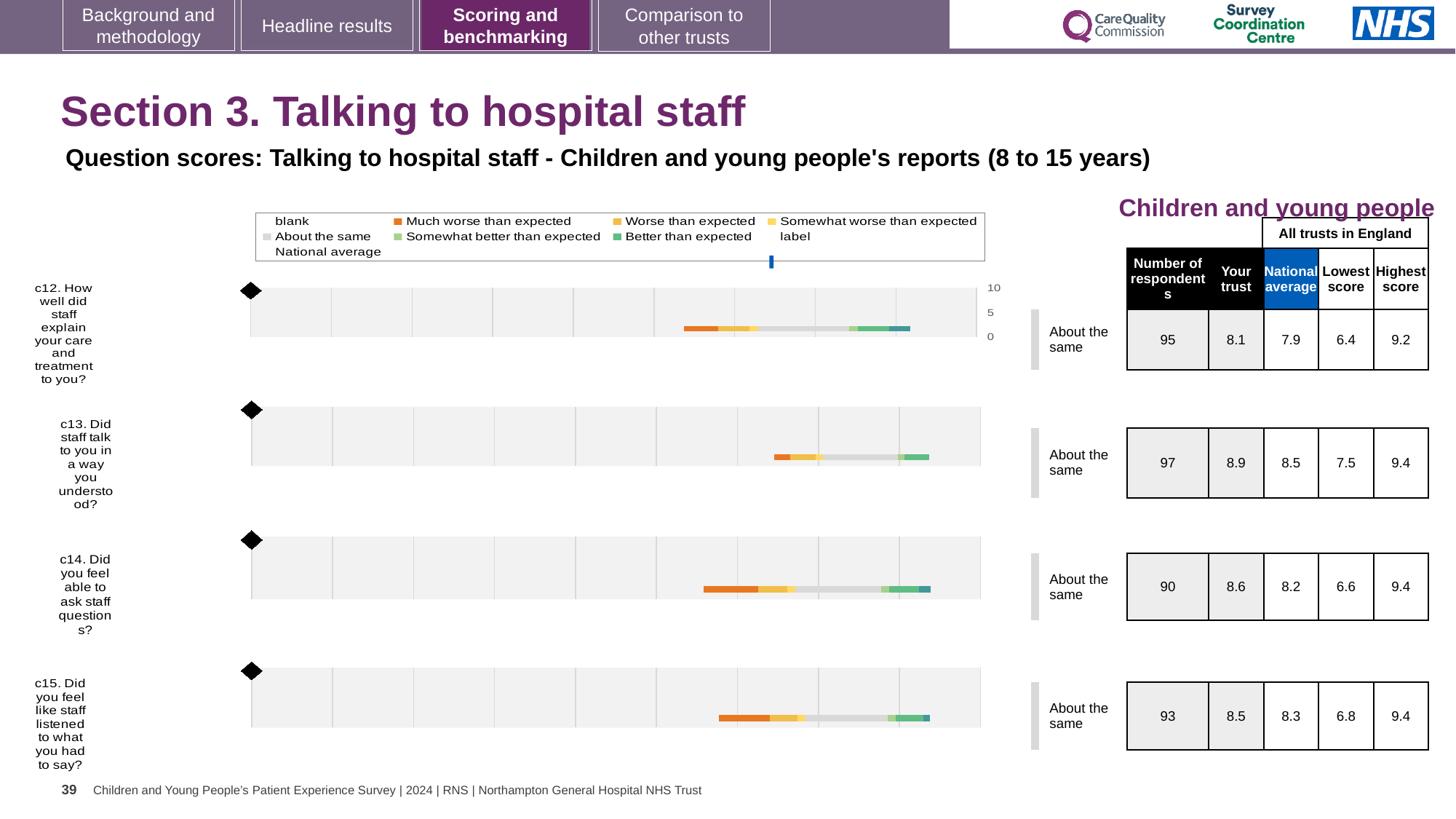
What benchmark label is shown for c12 next to its chart? About the same Which question has the lowest 'Lowest score' value in the table? c12 Is the 'Your trust' score for c14 larger than the national average for c14? Yes According to the table, what is the 'Your trust' score for c13 (Did staff talk to you in a way you understood)? 8.9 What kind of chart is used for the question scores on this slide? bar chart What is the difference between the 'Your trust' score and the national average for c15? 0.2 Which question has the highest 'Your trust' score in the table? c13 According to the table, what is the national average for c12 (How well did staff explain your care and treatment to you)? 7.9 According to the table, how many respondents answered c14 (Did you feel able to ask staff questions)? 90 What is the highest value shown on the vertical axis of the c12 chart? 10 Which colour does the legend use for 'Much worse than expected'? orange How many questions (c12 to c15) are plotted on the slide? 4